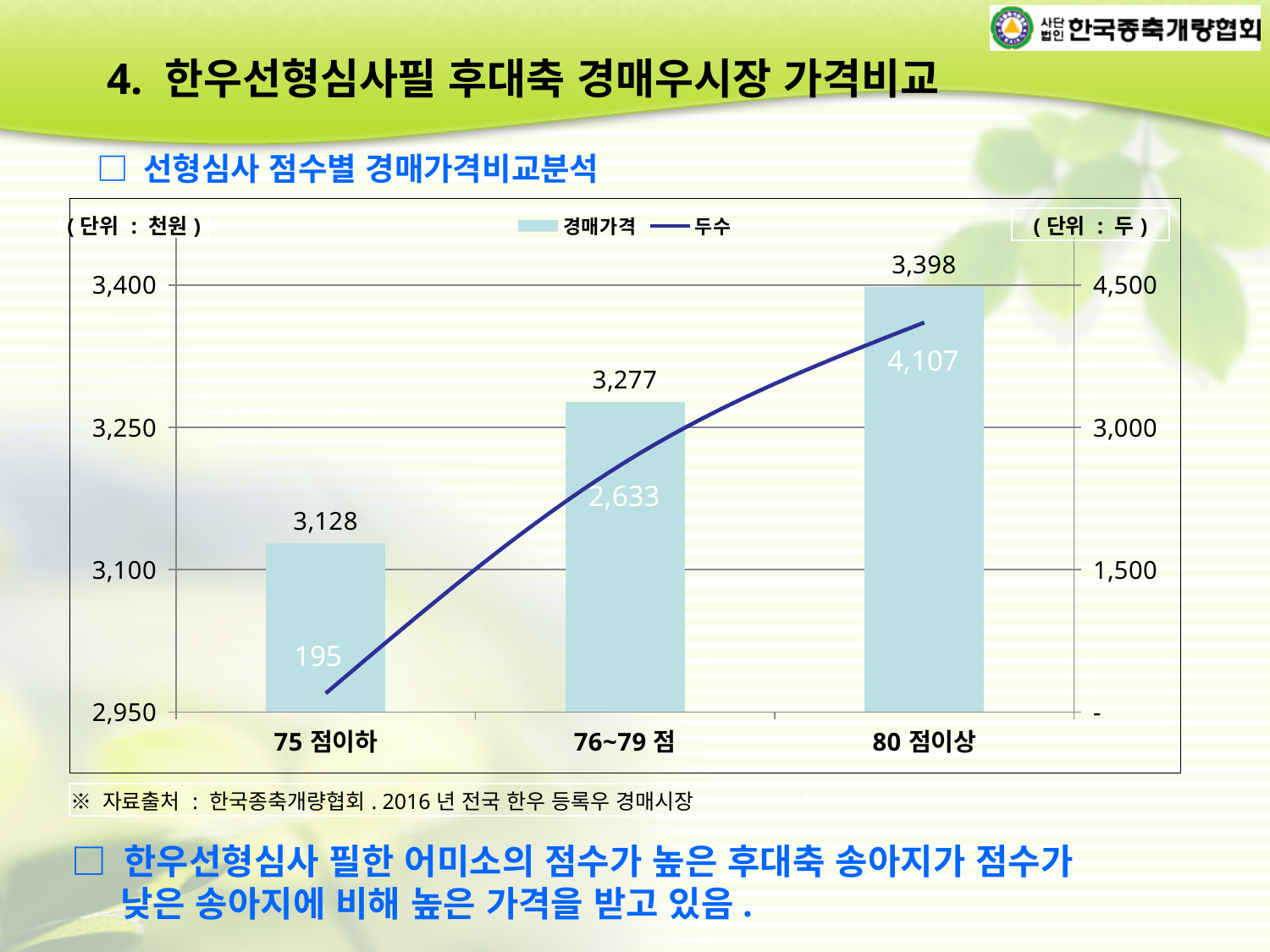
How many series does the legend list? 2 What is the difference in 경매가격 between 80 점이상 and 75 점이하? 270 Do the 경매가격 values rise or fall from 75 점이하 to 80 점이상? rise What is the 경매가격 value for 75 점이하? 3,128 Which category has the highest 경매가격 value? 80 점이상 What is the difference in 두수 between 80 점이상 and 76~79 점? 1,474 How many score categories are shown on the x axis? 3 What is the 두수 value for 76~79 점? 2,633 Which category has the lowest 두수 value? 75 점이하 What is the 경매가격 value for 80 점이상? 3,398 Which series is drawn as a line rather than bars? 두수 Which is larger, the 경매가격 for 76~79 점 or for 75 점이하? 76~79 점